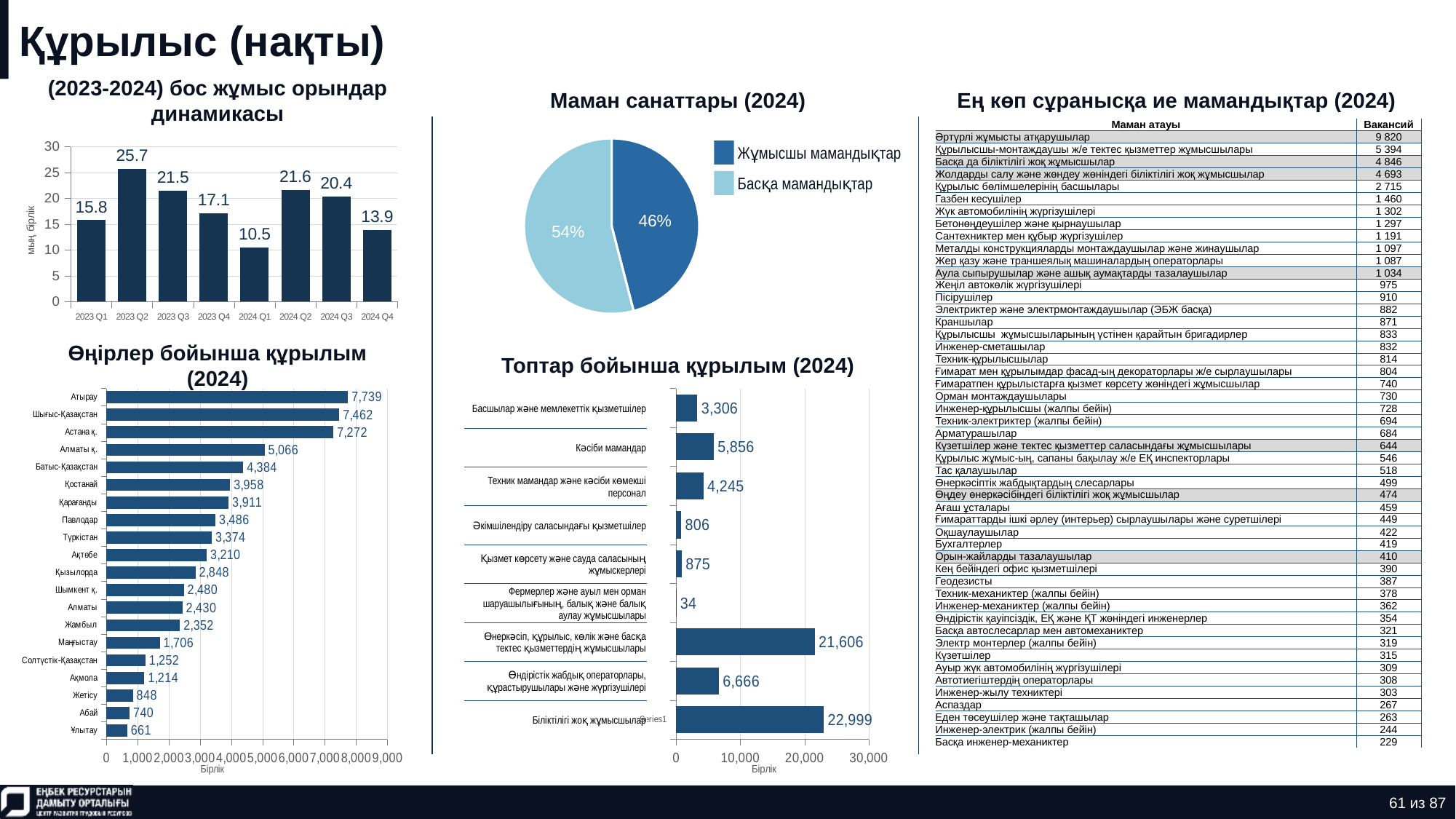
In the pie chart titled "Маман санаттары (2024)", what share does "Басқа мамандықтар" have? 54% In the chart titled "(2023-2024) бос жұмыс орындар динамикасы", how many quarters are plotted? 8 In the chart titled "Топтар бойынша құрылым (2024)", what is the value for "Кәсіби мамандар"? 5,856 In the chart titled "Өңірлер бойынша құрылым (2024)", what kind of chart is shown? Bar chart In the chart titled "(2023-2024) бос жұмыс орындар динамикасы", what is the value for 2023 Q2? 25.7 In the chart titled "Өңірлер бойынша құрылым (2024)", what is the value for Қарағанды? 3,911 In the chart titled "(2023-2024) бос жұмыс орындар динамикасы", which quarter has the lowest value? 2024 Q1 In the pie chart titled "Маман санаттары (2024)", how many entries does the legend list? 2 In the chart titled "Өңірлер бойынша құрылым (2024)", which is larger, the value for Астана қ. or the value for Алматы қ.? Астана қ. In the chart titled "Өңірлер бойынша құрылым (2024)", which region has the highest value? Атырау In the chart titled "(2023-2024) бос жұмыс орындар динамикасы", what is the difference between the values for 2023 Q2 and 2024 Q4? 11.8 In the chart titled "Топтар бойынша құрылым (2024)", which group has the lowest value? Фермерлер және ауыл мен орман шаруашылығының, балық және балық аулау жұмысшылары